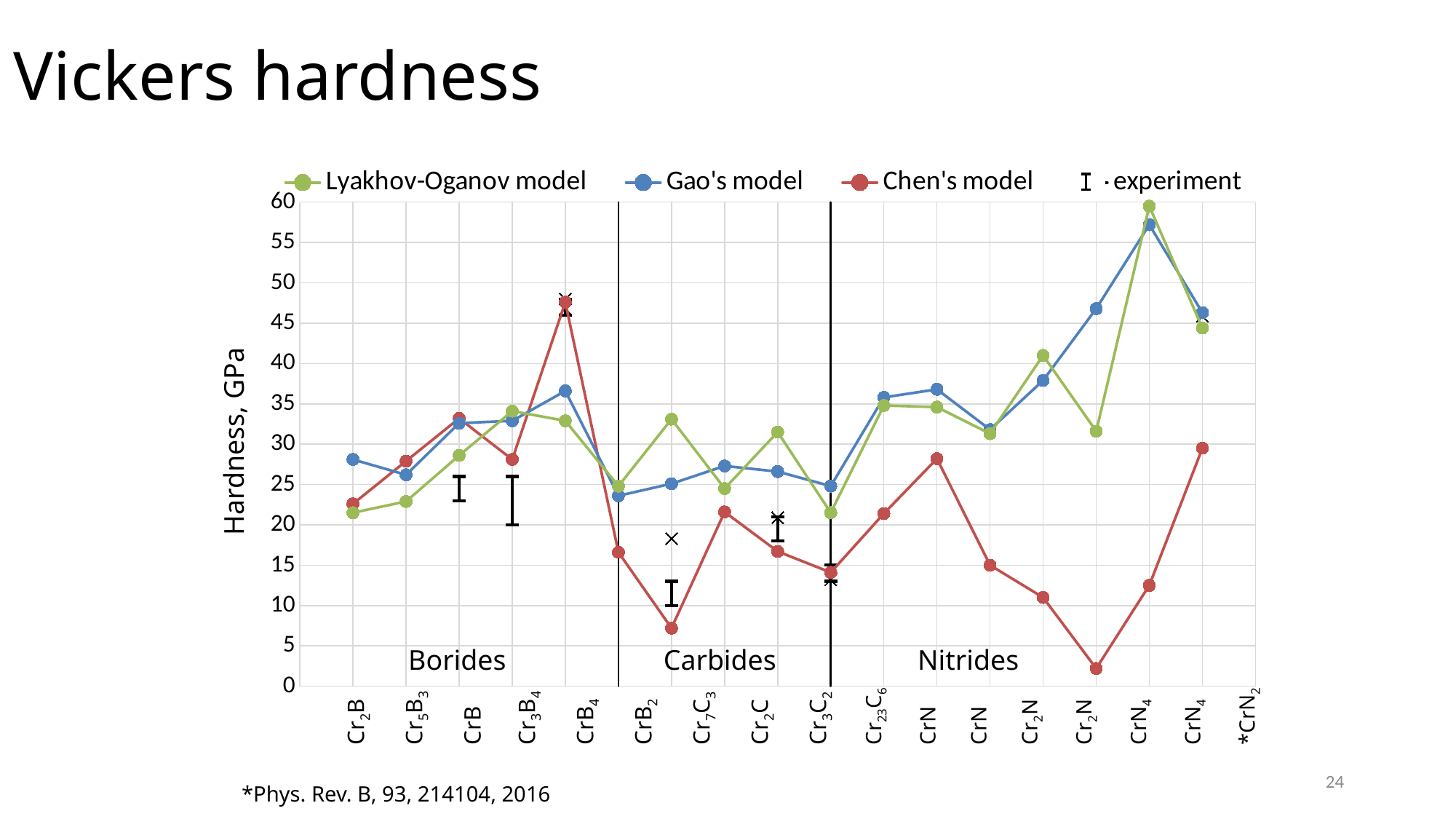
Does the Chen's model line rise or fall from CrN to the second Cr2N? fall For the Lyakhov-Oganov model, which category has the highest hardness? CrN4 (the first CrN4) Is the Chen's model value for CrB4 greater or less than 45? greater At CrB2, which is larger: the Lyakhov-Oganov model value or the Chen's model value? Lyakhov-Oganov model What is the label of the vertical axis? Hardness, GPa For Chen's model, which category has the highest hardness? CrB4 For Chen's model, which category has the lowest hardness? Cr2N (the second Cr2N) Is the Chen's model value for CrB2 greater or less than 10? less What are the three group labels written inside the plot area? Borides, Carbides, Nitrides Is the Gao's model value for the first CrN4 greater or less than 55? greater What kind of chart is shown on the slide? line chart How many entries does the chart legend list? 4